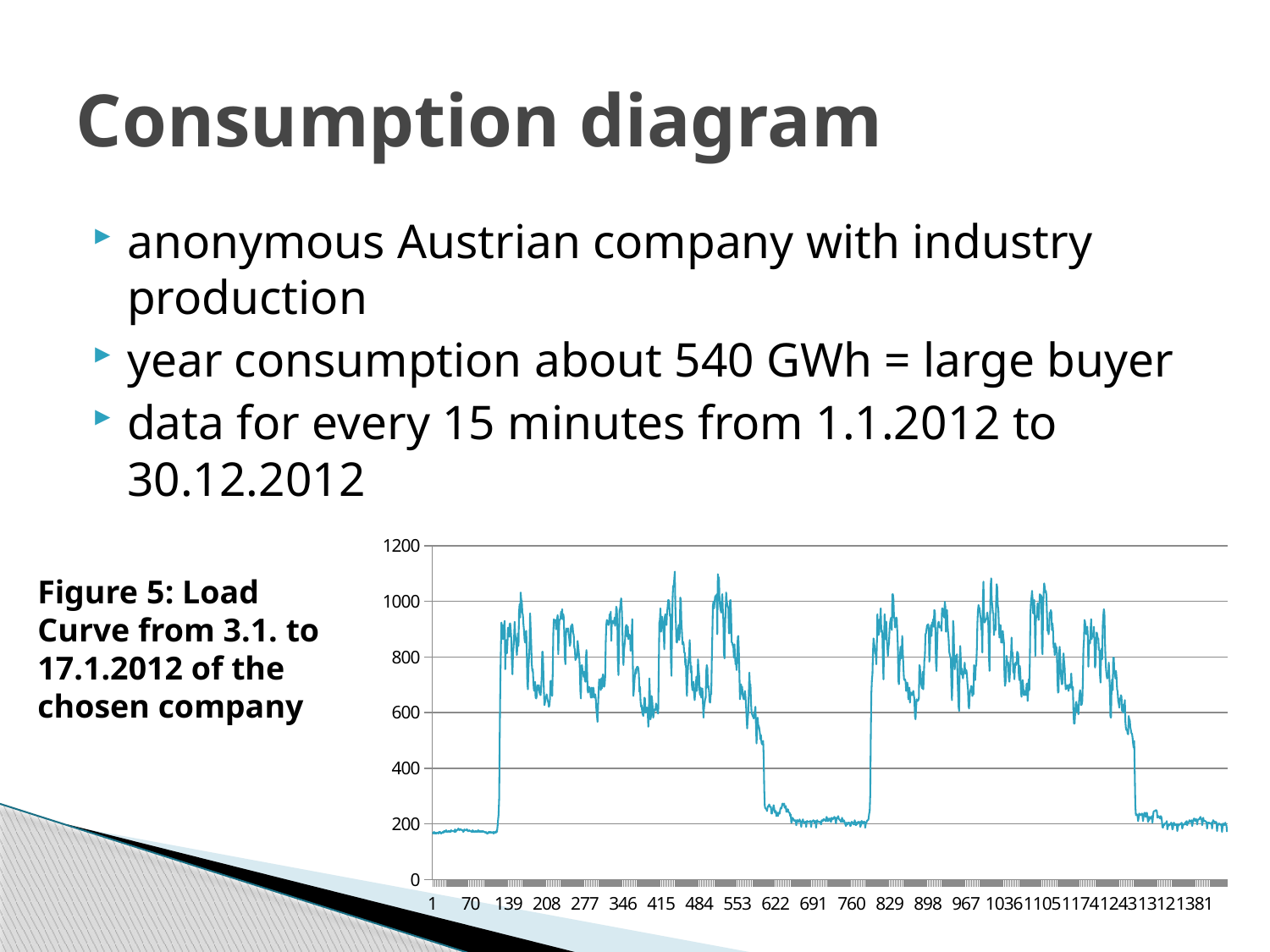
Does the line ever rise above 1200 on the chart? no Is the value at x = 1312 greater or less than 400? less Is the value at x = 1 greater or less than 200? less What is the caption of the chart on the slide? Figure 5: Load Curve from 3.1. to 17.1.2012 of the chosen company What is the last label shown on the horizontal axis of the chart? 1381 What is the highest value shown on the vertical axis of the chart? 1200 What kind of chart is shown on the slide? line chart